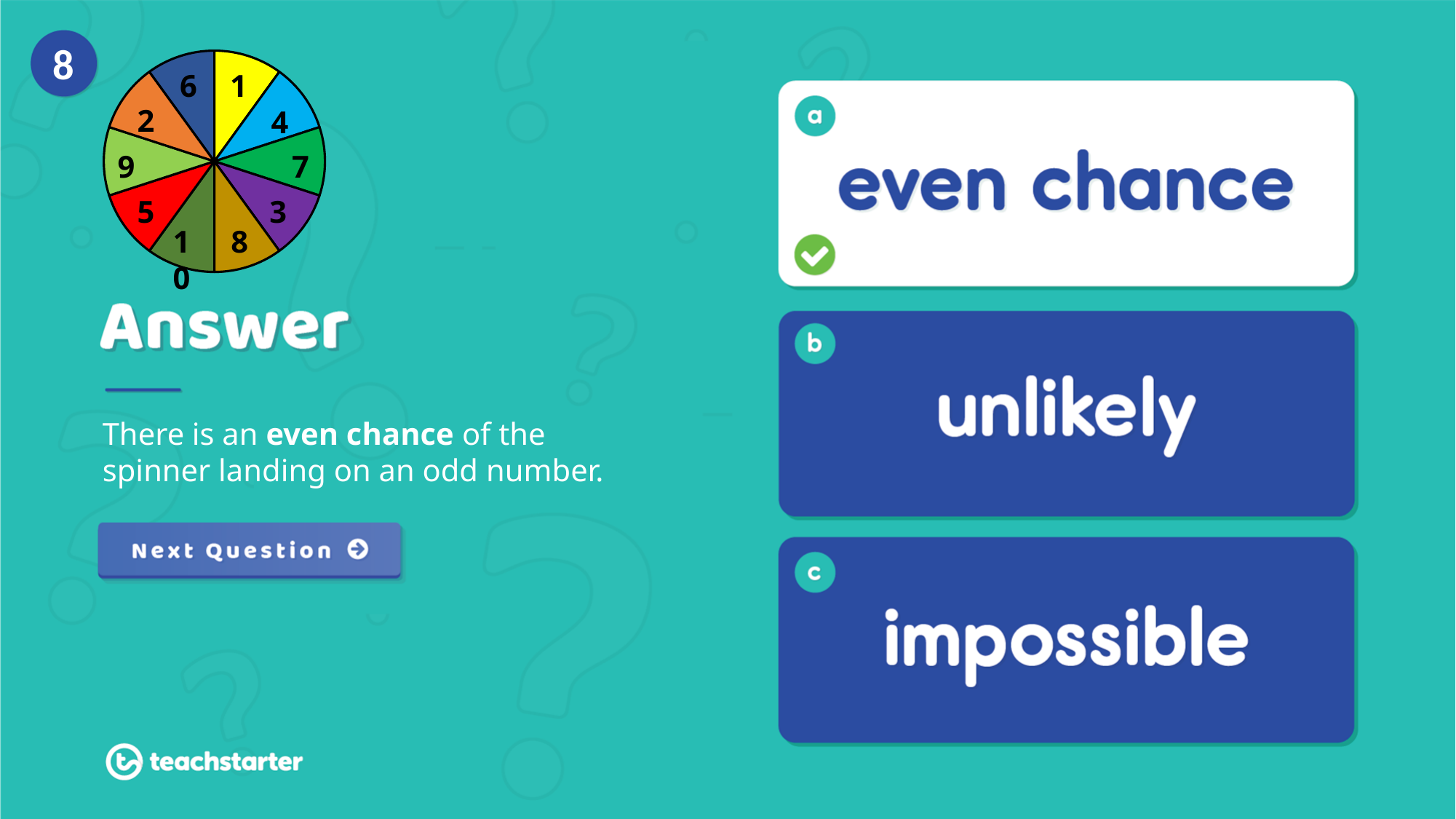
What kind of chart is the spinner on the slide? pie chart What is the difference between the number on the light green section (9) and the number on the orange section (2)? 7 How many sections does the spinner have? 10 Which answer option is marked as correct on the slide? even chance Which number on the spinner is larger, the one on the purple section or the one on the light blue section? 4 What number is printed on the red section of the spinner? 5 What number is printed on the yellow section of the spinner? 1